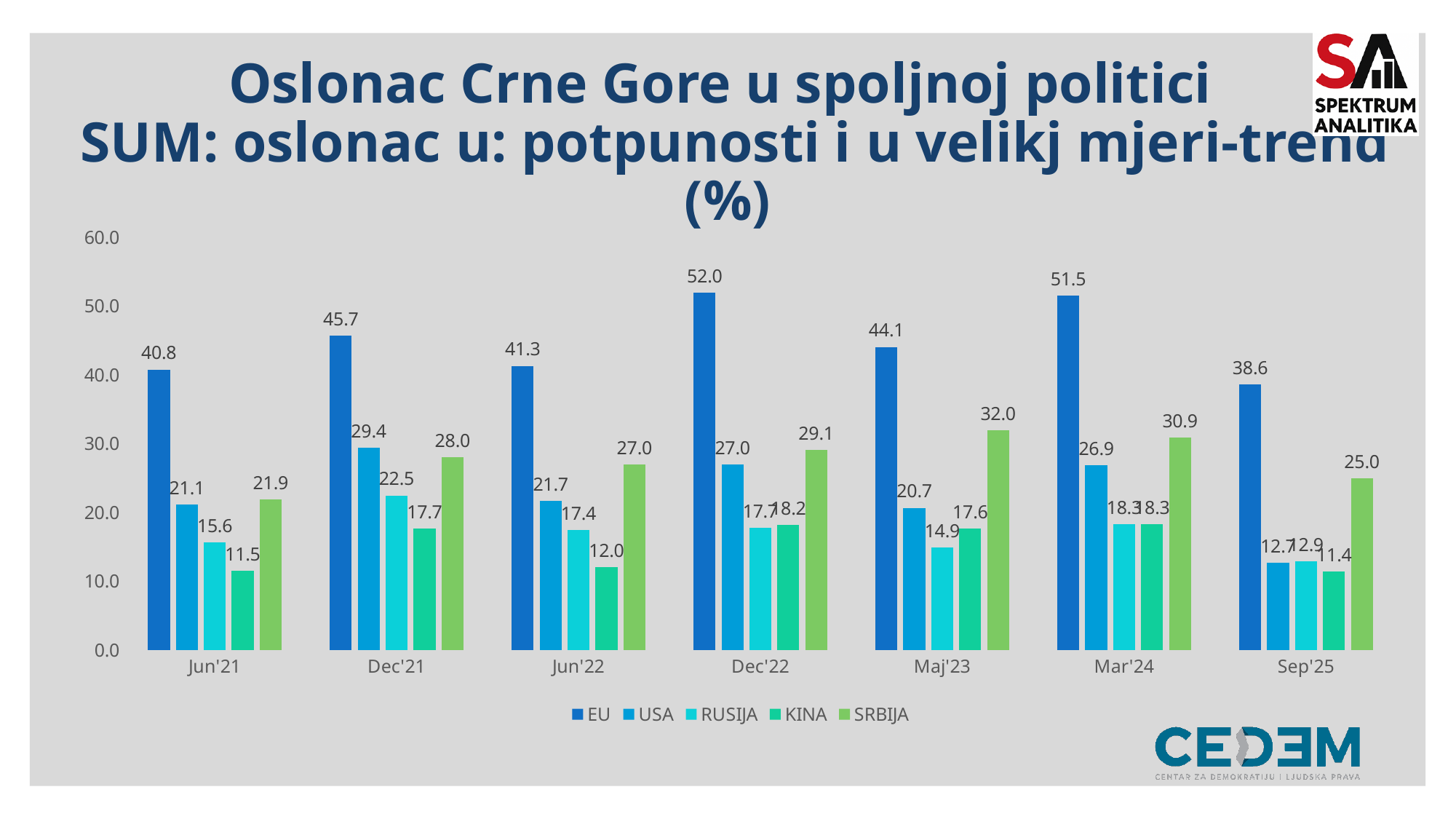
At which time point is the EU value highest? Dec'22 What kind of chart is shown on the slide? Bar chart What is the value for KINA at Jun'22? 12.0 At which time point is the EU value lowest? Sep'25 Which series is shown in green (the rightmost bar in each group)? SRBIJA What is the value for EU at Dec'22? 52.0 How many series does the legend list? 5 What is the value for USA at Dec'21? 29.4 Which is larger at Jun'21: the USA value or the SRBIJA value? SRBIJA What is the difference between the EU value at Dec'22 and the EU value at Sep'25? 13.4 What is the value for SRBIJA at Maj'23? 32.0 How many time points are shown on the x axis? 7